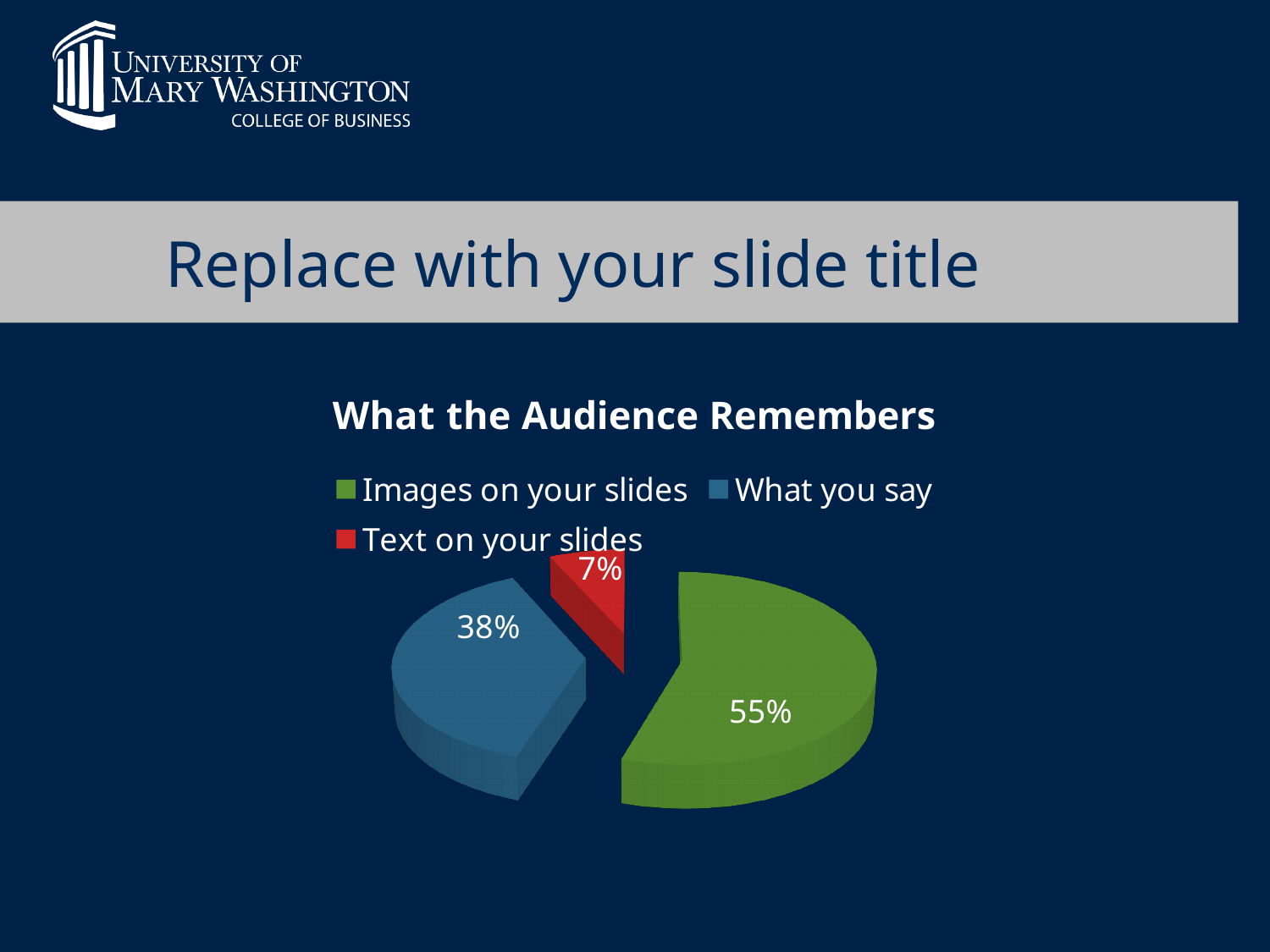
Which category has the smallest share of the pie? Text on your slides What is the title of the chart? What the Audience Remembers How many slices does the pie chart have? 3 What is the difference in percentage points between 'Images on your slides' and 'What you say'? 17 What percentage does the 'Images on your slides' slice show? 55% What kind of chart is shown on the slide? Pie chart What percentage does the 'Text on your slides' slice show? 7% Which is larger, the share for 'What you say' or the share for 'Text on your slides'? What you say What colour is the 'Text on your slides' slice? Red Which category has the largest share of the pie? Images on your slides What percentage does the 'What you say' slice show? 38% How many entries does the legend list? 3